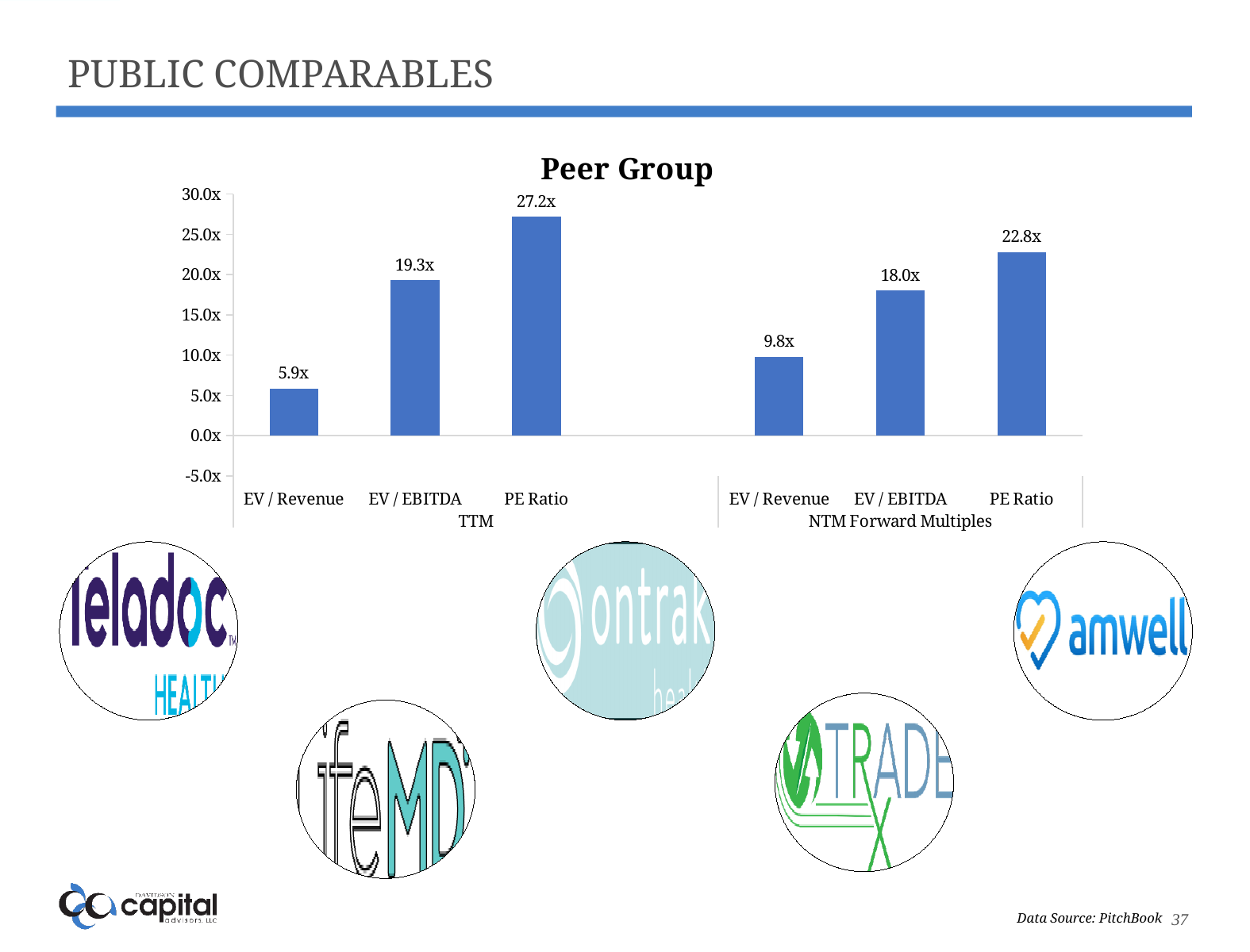
What type of chart is the Peer Group chart? Bar chart What is the difference between the NTM Forward EV / Revenue and the TTM EV / Revenue multiples in the Peer Group chart? 3.9x What is the NTM Forward EV / EBITDA multiple shown in the Peer Group chart? 18.0x What is the title of the chart on the slide? Peer Group How many bars are plotted in the Peer Group chart? 6 What is the NTM Forward PE Ratio shown in the Peer Group chart? 22.8x Which is larger in the Peer Group chart: the TTM EV / EBITDA multiple or the NTM Forward EV / EBITDA multiple? TTM EV / EBITDA What is the TTM PE Ratio shown in the Peer Group chart? 27.2x What is the difference between the TTM PE Ratio and the NTM Forward PE Ratio in the Peer Group chart? 4.4x Which bar in the Peer Group chart has the highest value? TTM PE Ratio Which bar in the Peer Group chart has the lowest value? TTM EV / Revenue What is the TTM EV / Revenue multiple shown in the Peer Group chart? 5.9x